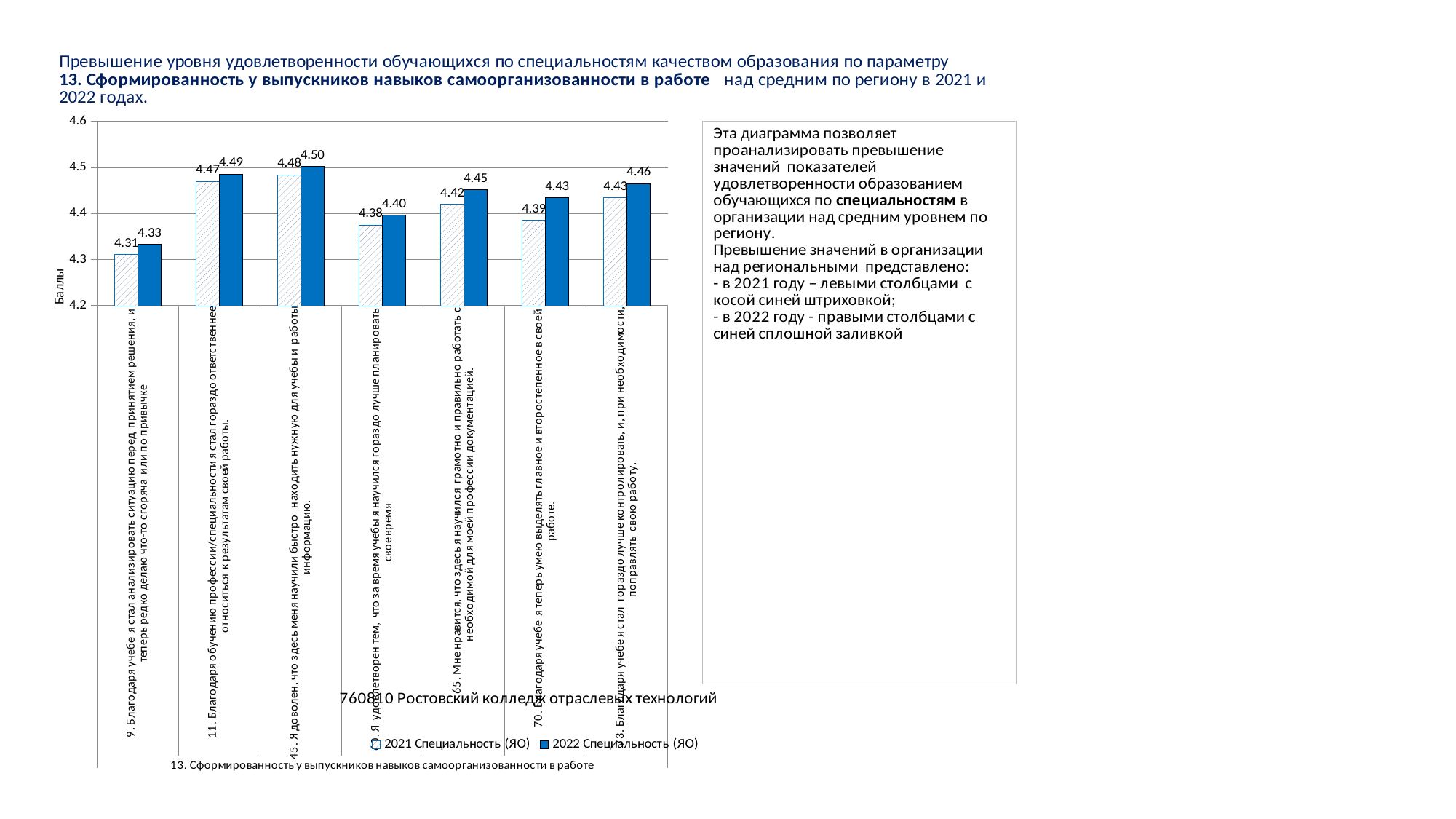
What is the 2021 Специальность (ЯО) value for statement 9 (Благодаря учебе я стал анализировать ситуацию перед принятием решения)? 4.31 Which is larger for statement 65 (научился грамотно и правильно работать с документацией): the 2021 value or the 2022 value? 2022 (4.45) Which statement has the lowest 2021 Специальность (ЯО) value? 9. Благодаря учебе я стал анализировать ситуацию перед принятием решения, и теперь редко делаю что-то сгоряча или по привычке What is the difference between the 2022 and 2021 Специальность (ЯО) values for statement 70 (умею выделять главное и второстепенное)? 0.04 How many series does the legend list? 2 Is the 2021 Специальность (ЯО) value for statement 11 (стал гораздо ответственнее относиться к результатам своей работы) greater or less than 4.4? greater What kind of chart is shown on the slide? bar chart What is the 2021 Специальность (ЯО) value for statement 70 (Благодаря учебе я теперь умею выделять главное и второстепенное в своей работе)? 4.39 What is the 2022 Специальность (ЯО) value for statement 45 (Я доволен, что здесь меня научили быстро находить нужную для учебы и работы информацию)? 4.50 Which statement has the highest 2022 Специальность (ЯО) value? 45. Я доволен, что здесь меня научили быстро находить нужную для учебы и работы информацию What is the label of the vertical axis? Баллы How many categories (statements) are plotted on the x axis? 7